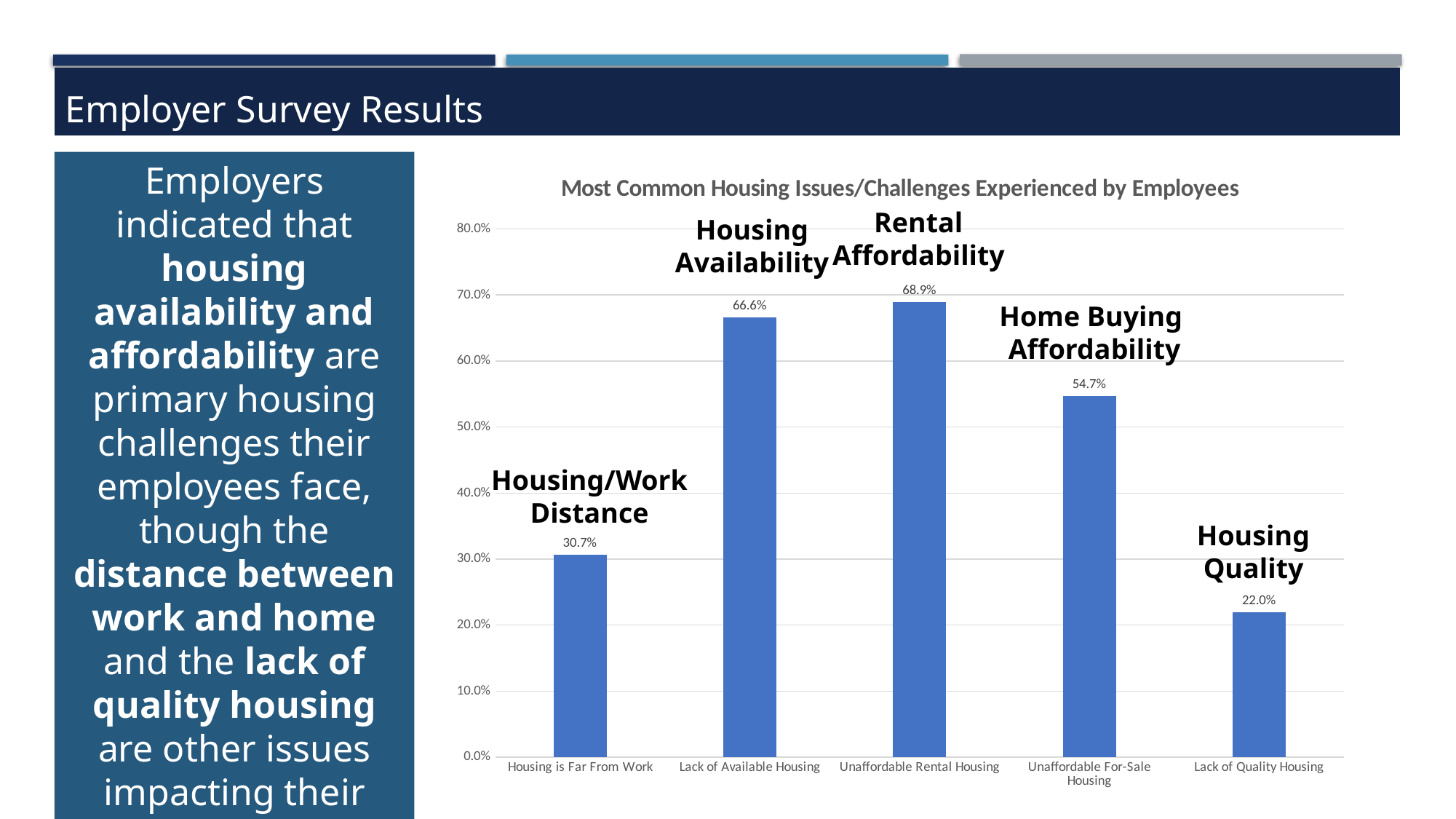
What is the value for Unaffordable For-Sale Housing? 54.7% Which category has the highest value? Unaffordable Rental Housing What is the difference between Lack of Available Housing and Unaffordable For-Sale Housing? 11.9% Which category has the lowest value? Lack of Quality Housing Which is larger, Housing is Far From Work or Lack of Quality Housing? Housing is Far From Work What kind of chart is shown? Bar chart What is the value for Unaffordable Rental Housing? 68.9% What is the value for Housing is Far From Work? 30.7% How many categories are shown on the x axis? 5 What is the value for Lack of Quality Housing? 22.0% What is the title of the chart? Most Common Housing Issues/Challenges Experienced by Employees Is the value for Unaffordable For-Sale Housing greater or less than 50.0%? greater